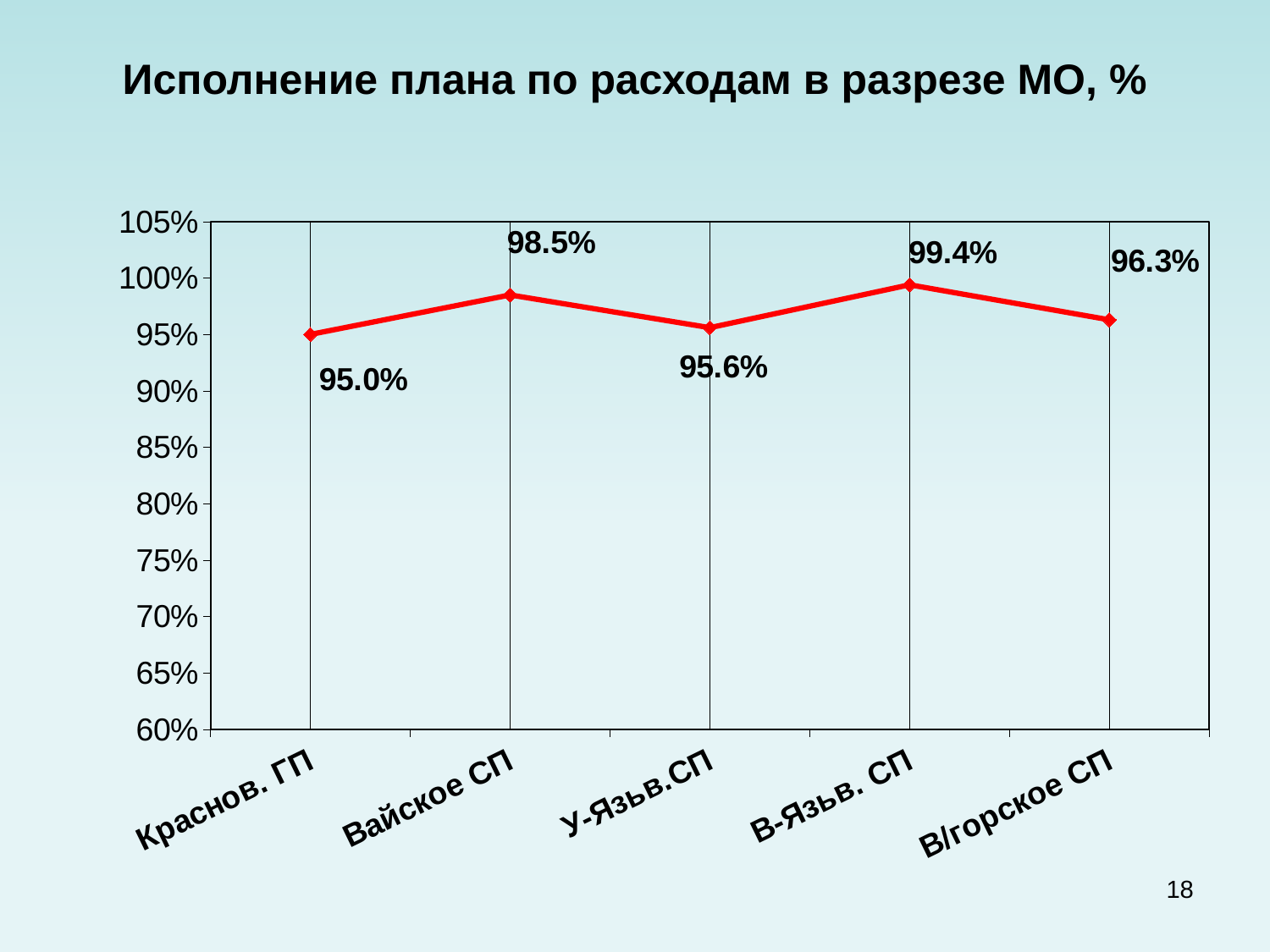
Which category has the lowest value? Краснов. ГП How many categories are plotted on the chart? 5 What is the title of the chart? Исполнение плана по расходам в разрезе МО, % Is the value for В-Язьв. СП greater or less than 100%? less What is the difference between the values for В-Язьв. СП and У-Язьв.СП? 3.8% What is the value for Краснов. ГП? 95.0% What is the value for Вайское СП? 98.5% What is the value for В/горское СП? 96.3% Which category has the highest value? В-Язьв. СП Which is larger, the value for Вайское СП or the value for В/горское СП? Вайское СП What colour is the line on the chart? red What kind of chart is shown on the slide? line chart